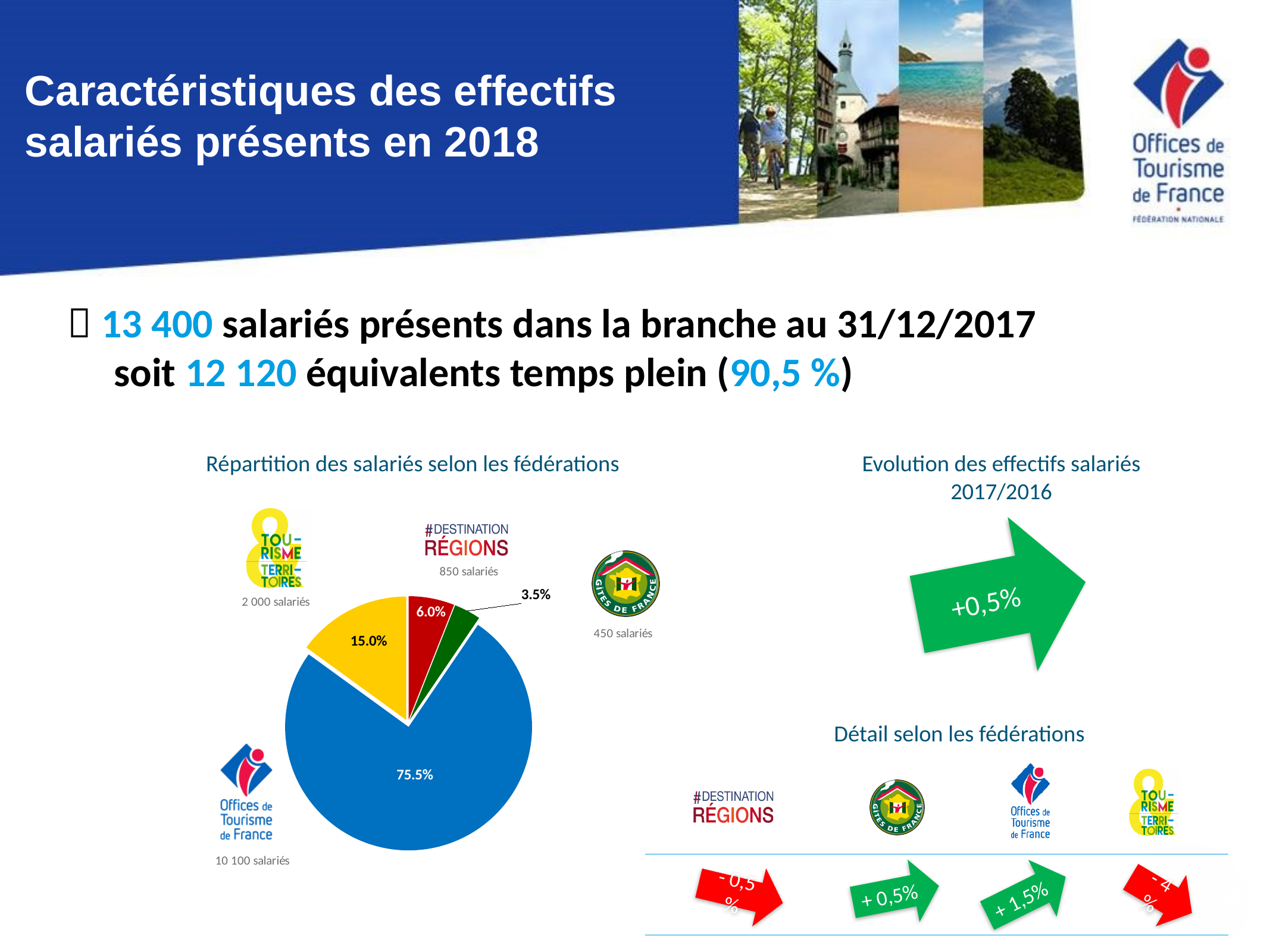
In the pie chart, what share of salariés belongs to Gîtes de France? 3.5% What is the title of the pie chart on the slide? Répartition des salariés selon les fédérations According to the pie chart labels, how many salariés does Destination Régions have? 850 salariés In the pie chart, what is the difference in percentage points between the Tourisme & Territoires share and the Destination Régions share? 9.0 percentage points Which fédération has the smallest slice in the pie chart? Gîtes de France In the pie chart, what share of salariés belongs to Destination Régions? 6.0% Which fédération has the largest slice in the pie chart? Offices de Tourisme de France In the pie chart, which has a larger share: Tourisme & Territoires or Destination Régions? Tourisme & Territoires What kind of chart is used for 'Répartition des salariés selon les fédérations'? Pie chart In the pie chart, what share of salariés belongs to Tourisme & Territoires? 15.0% How many slices does the pie chart 'Répartition des salariés selon les fédérations' have? 4